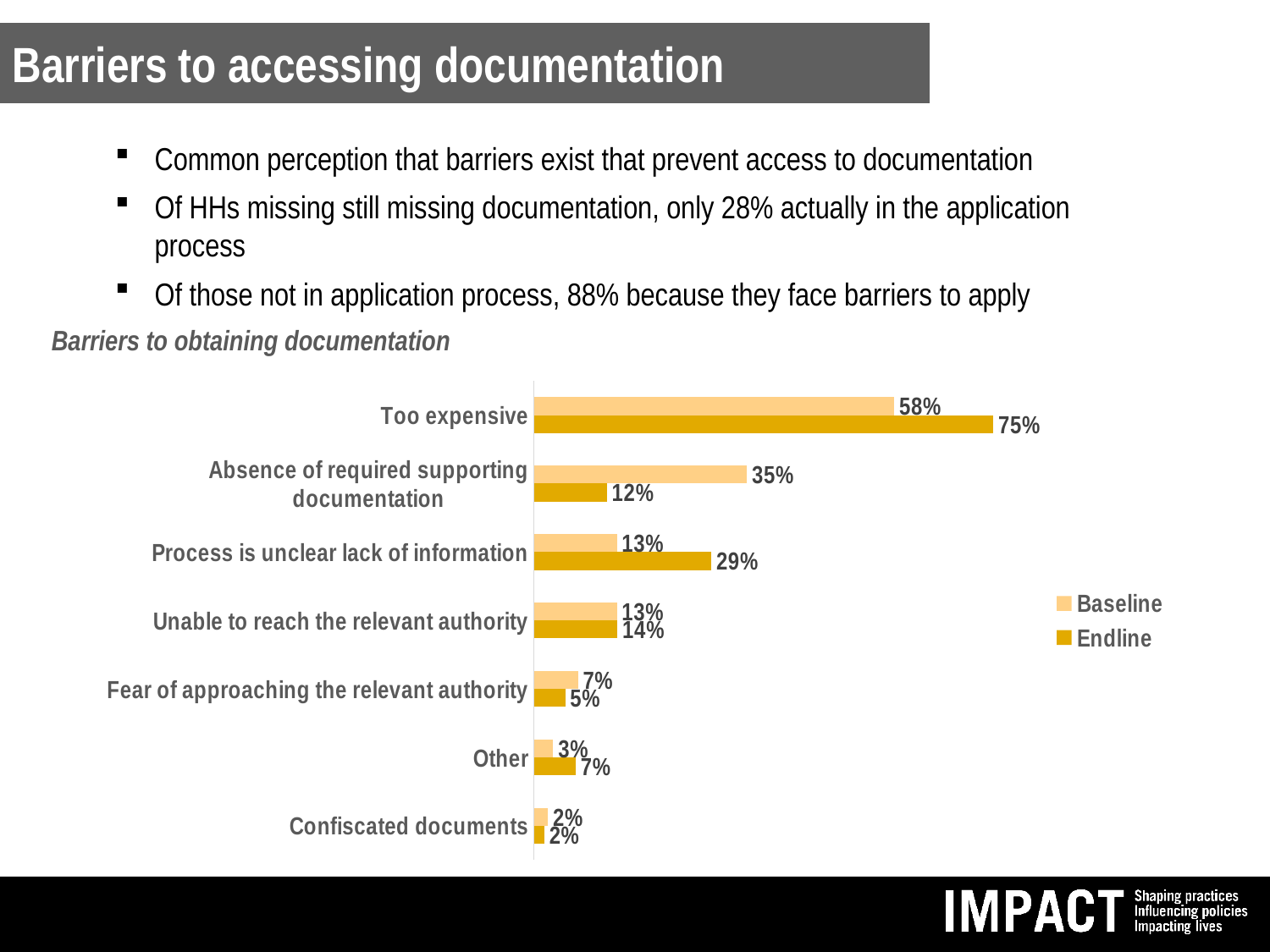
Which barrier has the lowest Baseline value? Confiscated documents What is the Endline value for Process is unclear lack of information? 29% How many barrier categories are shown in the chart? 7 Which is larger for Absence of required supporting documentation, the Baseline or the Endline value? Baseline What is the difference between the Baseline and Endline values for Absence of required supporting documentation? 23% What is the Endline value for Too expensive? 75% What is the Baseline value for Absence of required supporting documentation? 35% What is the title of the chart? Barriers to obtaining documentation What is the difference between the Endline and Baseline values for Too expensive? 17% How many series does the legend list? 2 What kind of chart is shown on the slide? Bar chart Which barrier has the highest Endline value? Too expensive